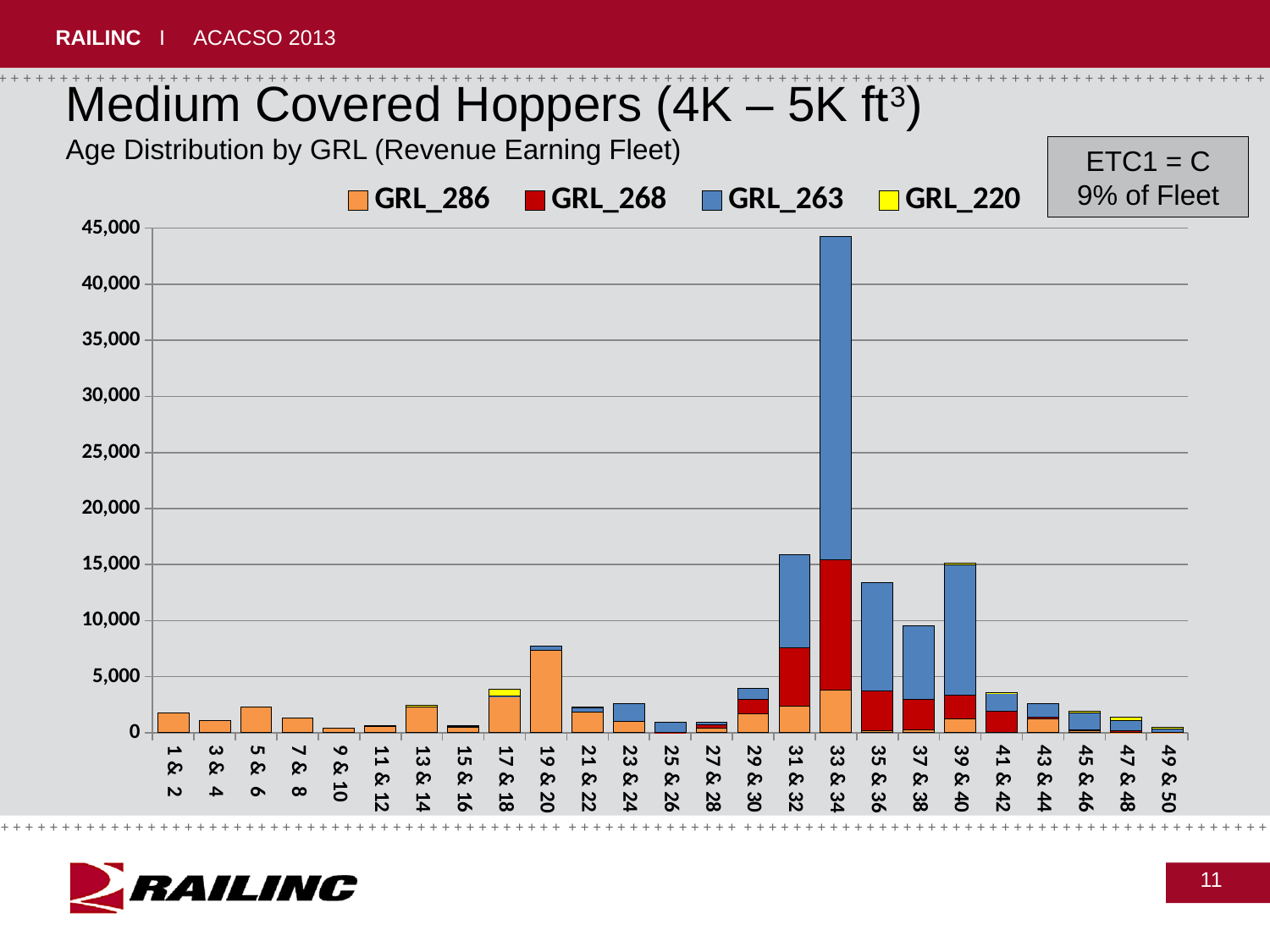
What is the subtitle of the chart below the main title? Age Distribution by GRL (Revenue Earning Fleet) Which series is shown in orange in the legend? GRL_286 How many age categories are shown along the x axis? 25 How many series does the legend list? 4 Is the total value for 19 & 20 greater or less than 5,000? greater Is the total value for 39 & 40 greater or less than 20,000? less What kind of chart is shown on the slide? Stacked bar chart Which age category has the highest total bar? 33 & 34 Is the total value for 31 & 32 greater or less than 10,000? greater Which has the larger total bar, 19 & 20 or 21 & 22? 19 & 20 Which has the larger total bar, 33 & 34 or 31 & 32? 33 & 34